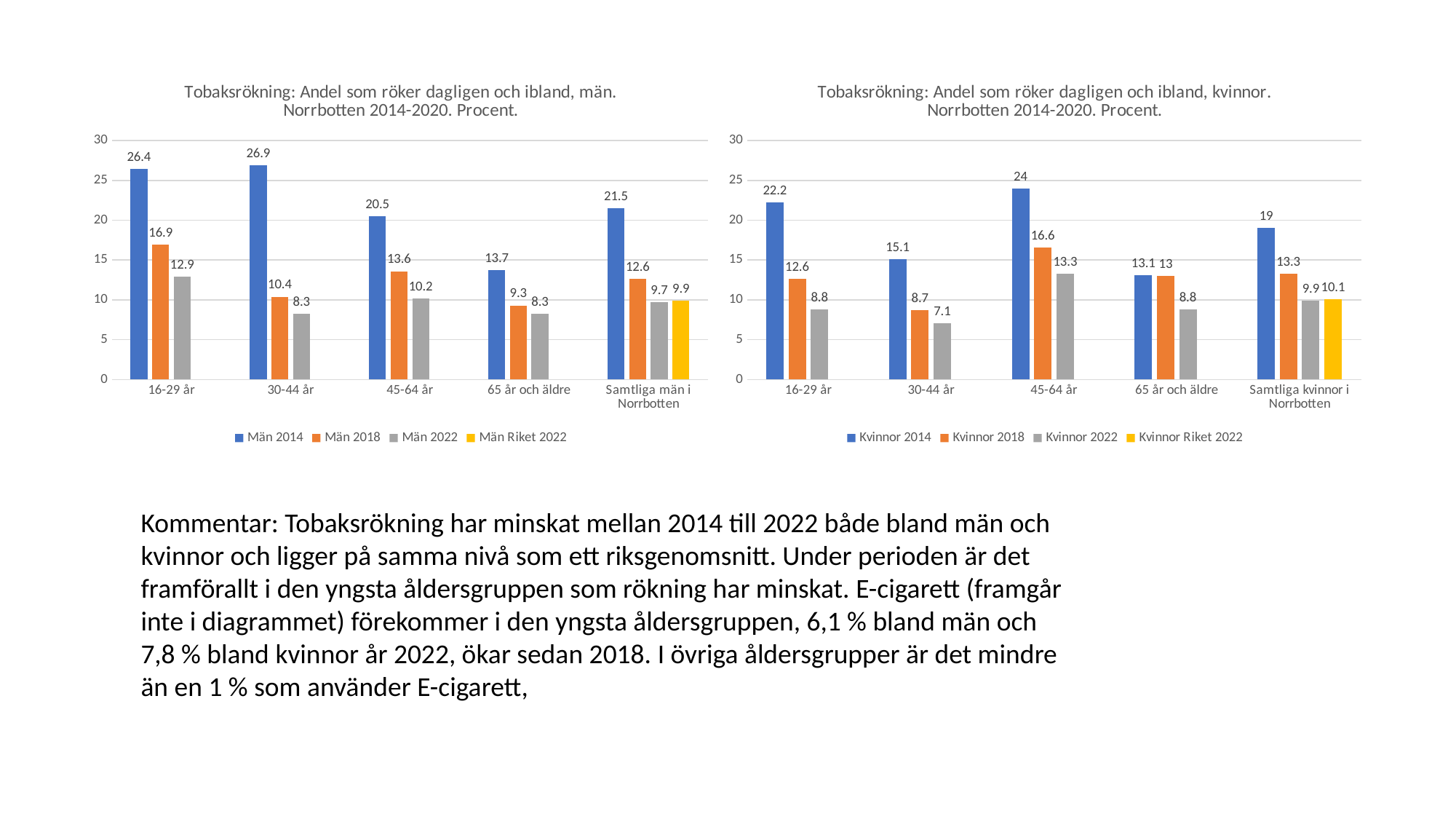
In the left chart (men), what is the value for Män 2014 in the 16-29 år group? 26.4 In the right chart (women), which age group has the highest value for Kvinnor 2014? 45-64 år In the left chart (men), which category has the lowest value for Män 2018? 65 år och äldre What kind of chart is the left chart (men)? Bar chart In the left chart (men), do the values for Män 2014 rise or fall from 30-44 år to 65 år och äldre? Fall How many categories are shown on the x axis of the right chart (women)? 5 In the left chart (men), what is the value for Män Riket 2022? 9.9 In the left chart (men), what is the difference between Män 2014 and Män 2022 for the 16-29 år group? 13.5 In the right chart (women), what is the difference between Kvinnor 2022 and Kvinnor Riket 2022 for Samtliga kvinnor i Norrbotten? 0.2 In the right chart (women), what is the value for Kvinnor 2022 in the 30-44 år group? 7.1 How many series does the legend of the left chart (men) list? 4 In the right chart (women), which is larger for the 45-64 år group: Kvinnor 2018 or Kvinnor 2022? Kvinnor 2018